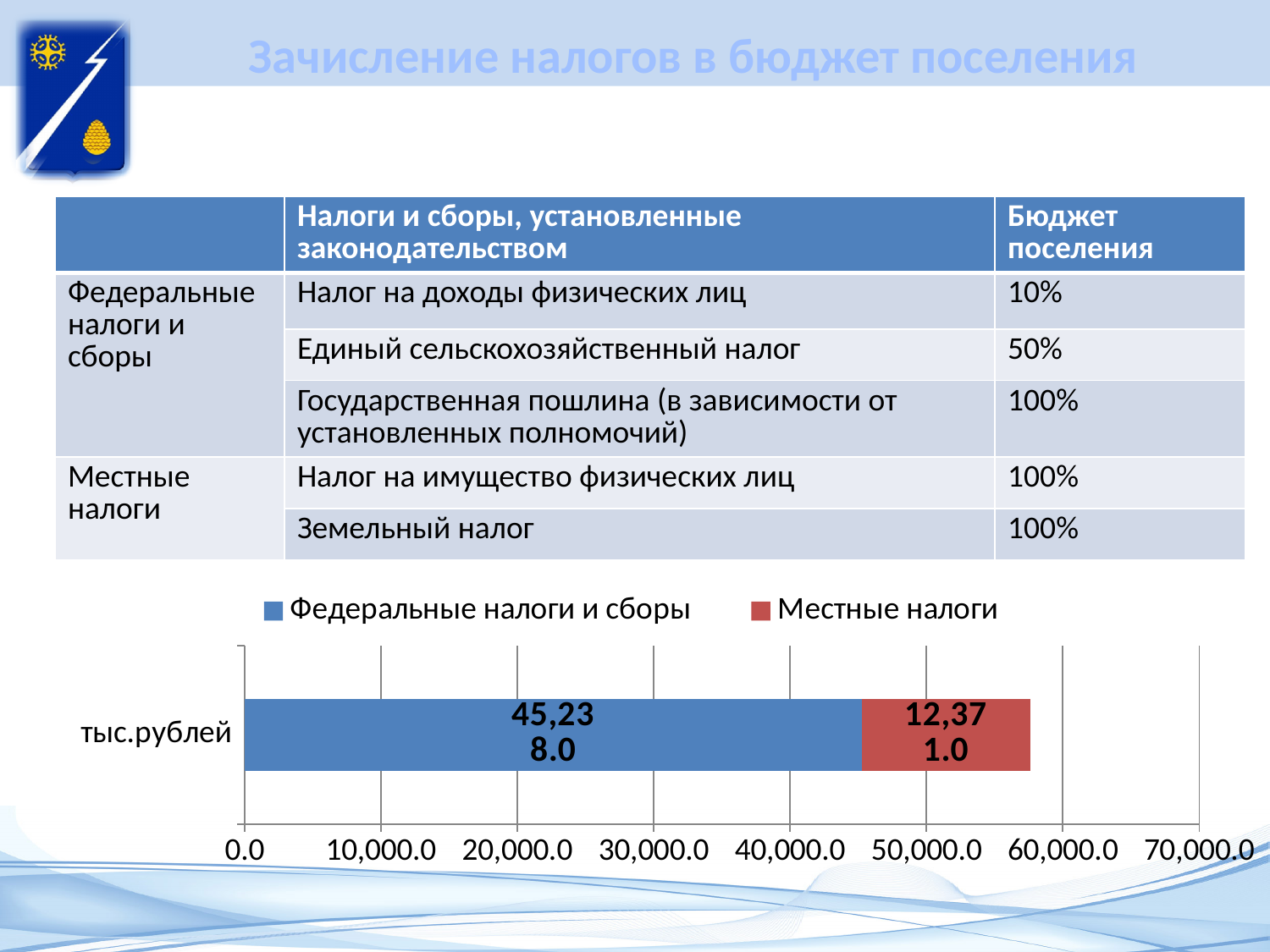
What kind of chart is shown at the bottom of the slide? bar chart What is the value for Местные налоги in the chart? 12,371.0 What is the difference between the values for Федеральные налоги и сборы and Местные налоги? 32,867.0 What is the value for Федеральные налоги и сборы in the chart? 45,238.0 Is the value for Местные налоги greater or less than 20,000.0? less What is the total of the stacked bar for тыс.рублей? 57,609.0 What is the label of the category on the chart's vertical axis? тыс.рублей Is the value for Федеральные налоги и сборы greater or less than 40,000.0? greater How many categories are shown on the chart's vertical axis? 1 How many series does the chart legend list? 2 Which series has the larger value in the chart, Федеральные налоги и сборы or Местные налоги? Федеральные налоги и сборы What colour is the Местные налоги series in the chart? red